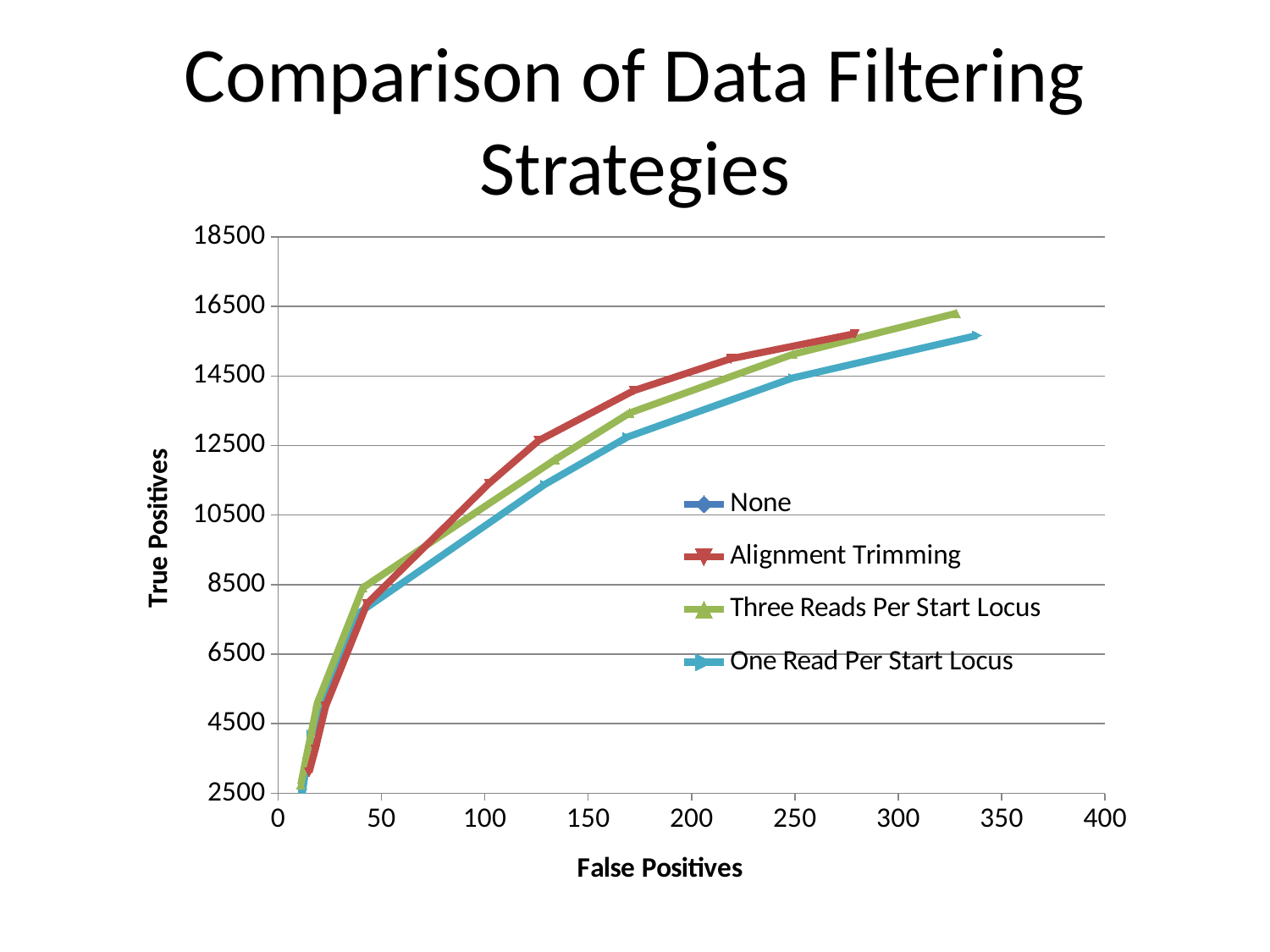
Do the true positives rise or fall as false positives increase along the x axis? rise Which series reaches the highest true positives value on the chart? Three Reads Per Start Locus Which series extends furthest along the False Positives axis? One Read Per Start Locus Is the true positives value for One Read Per Start Locus at 150 false positives greater or less than 12500? less What is the label of the y axis? True Positives Is the true positives value for Alignment Trimming at 250 false positives greater or less than 14500? greater Is the highest true positives value for Three Reads Per Start Locus greater or less than 14500? greater How many series does the legend list? 4 What kind of chart is shown on the slide? line chart What is the title of the chart? Comparison of Data Filtering Strategies